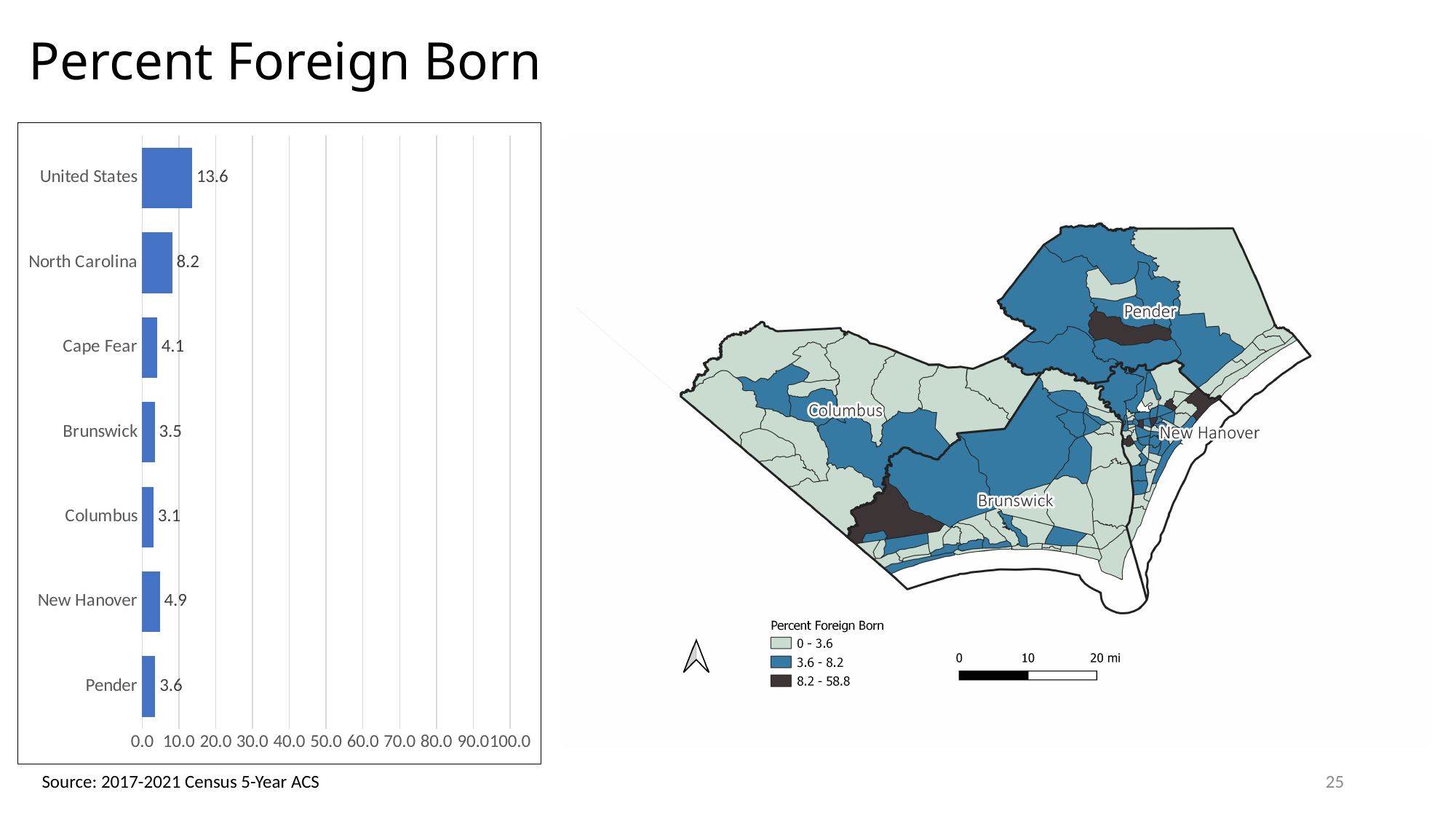
What is the value for Cape Fear in the bar chart? 4.1 Which category has the highest value in the bar chart? United States What is the value for Pender in the bar chart? 3.6 What is the value for North Carolina in the bar chart? 8.2 What kind of chart is shown on the left of the slide? bar chart Which has a larger value in the bar chart, New Hanover or Brunswick? New Hanover Is the value for United States in the bar chart greater or less than 10.0? greater Which category has the lowest value in the bar chart? Columbus What is the value for United States in the bar chart? 13.6 What is the title of the slide containing the bar chart? Percent Foreign Born How many categories are shown in the bar chart? 7 What is the difference between the values for United States and North Carolina in the bar chart? 5.4